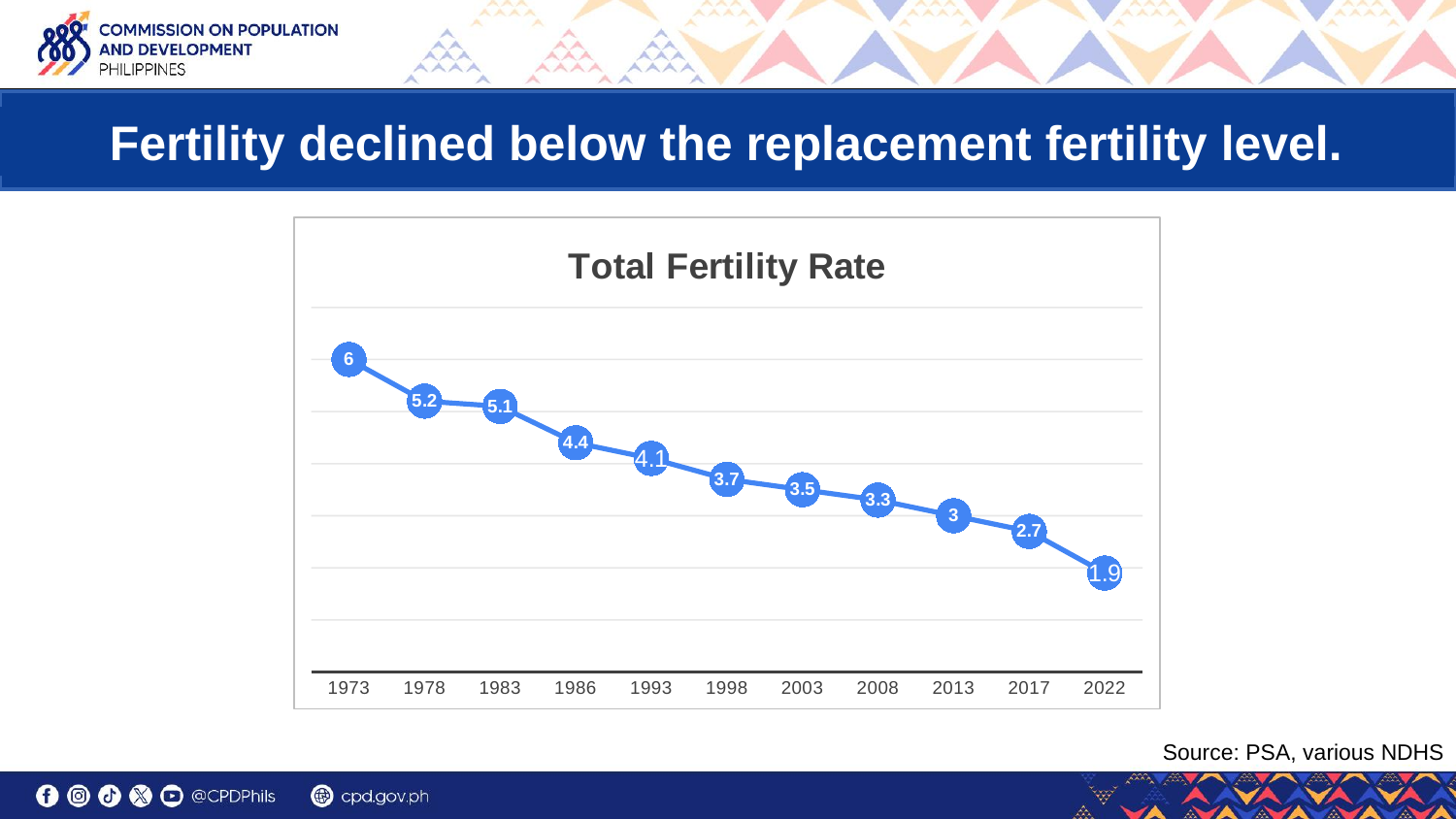
What is the Total Fertility Rate for 2022? 1.9 What is the difference between the Total Fertility Rate in 2017 and in 2022? 0.8 Does the Total Fertility Rate rise or fall from 1973 to 2022? Fall Which year has a higher Total Fertility Rate, 1986 or 2003? 1986 What is the Total Fertility Rate for 2013? 3 Which year has the highest Total Fertility Rate? 1973 What is the Total Fertility Rate for 1998? 3.7 How many years are plotted on the Total Fertility Rate chart? 11 Which year has the lowest Total Fertility Rate? 2022 What kind of chart is used to show the Total Fertility Rate? Line chart What is the difference between the Total Fertility Rate in 1973 and in 2022? 4.1 What is the Total Fertility Rate for 1973? 6